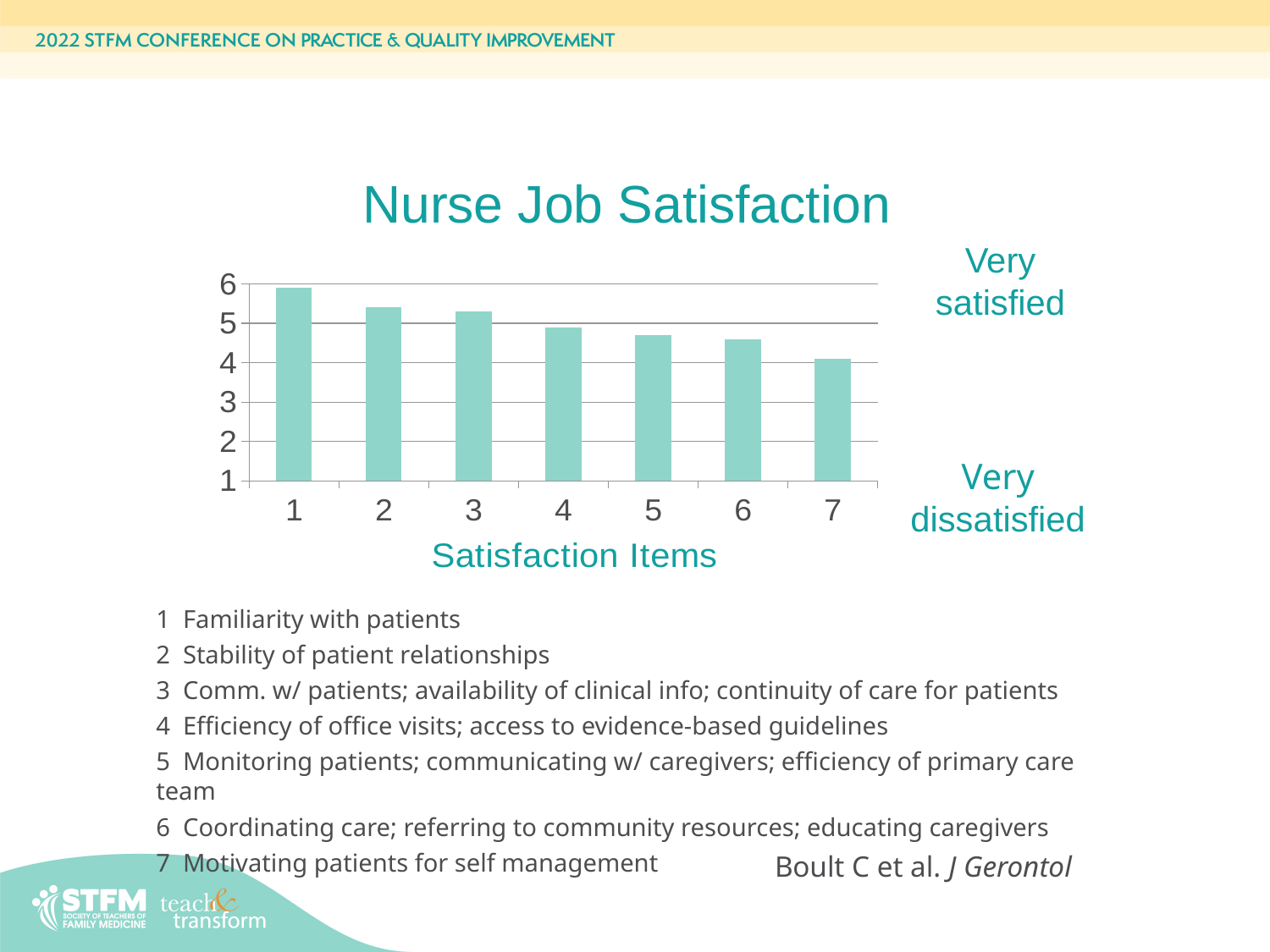
Which satisfaction item has the lowest bar? 7 What is the title of the chart? Nurse Job Satisfaction Is the value for satisfaction item 5 greater or less than 5? less Do the values rise or fall as the satisfaction item number increases from 1 to 7? fall Which has a lower value, satisfaction item 1 or satisfaction item 7? 7 Is the value for satisfaction item 7 greater or less than 5? less Which has a higher value, satisfaction item 2 or satisfaction item 6? 2 Is the value for satisfaction item 1 greater or less than 5? greater Which satisfaction item has the highest bar? 1 What is the label of the x axis? Satisfaction Items What kind of chart is shown on the slide? bar chart How many satisfaction items are plotted on the chart? 7